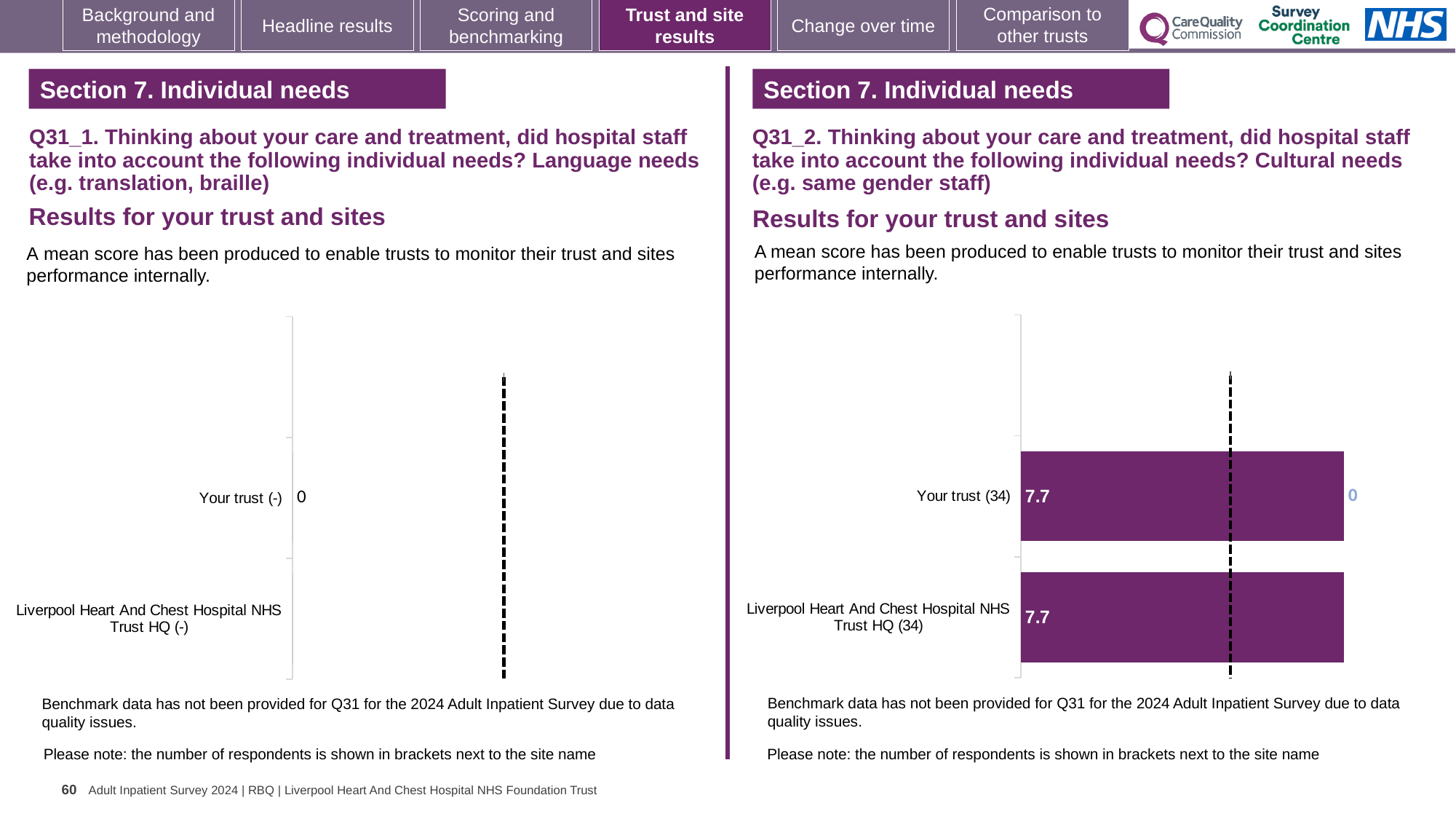
On the Q31_1 chart (left), what value is shown for Your trust (-)? 0 On the Q31_2 chart (right), what is the difference between the score for Your trust (34) and the score for Liverpool Heart And Chest Hospital NHS Trust HQ (34)? 0 On the Q31_2 chart (right), how many respondents are shown in brackets next to Your trust? 34 How many categories are plotted on the Q31_2 chart (right)? 2 On the Q31_2 chart (right), what is the mean score for Your trust (34)? 7.7 On the Q31_2 chart (right), what is the mean score for Liverpool Heart And Chest Hospital NHS Trust HQ (34)? 7.7 How many categories are listed on the Q31_1 chart (left)? 2 How many charts are shown on the slide? 2 What kind of chart is the Q31_2 chart (right)? Bar chart On the Q31_2 chart (right), what colour are the bars? Purple